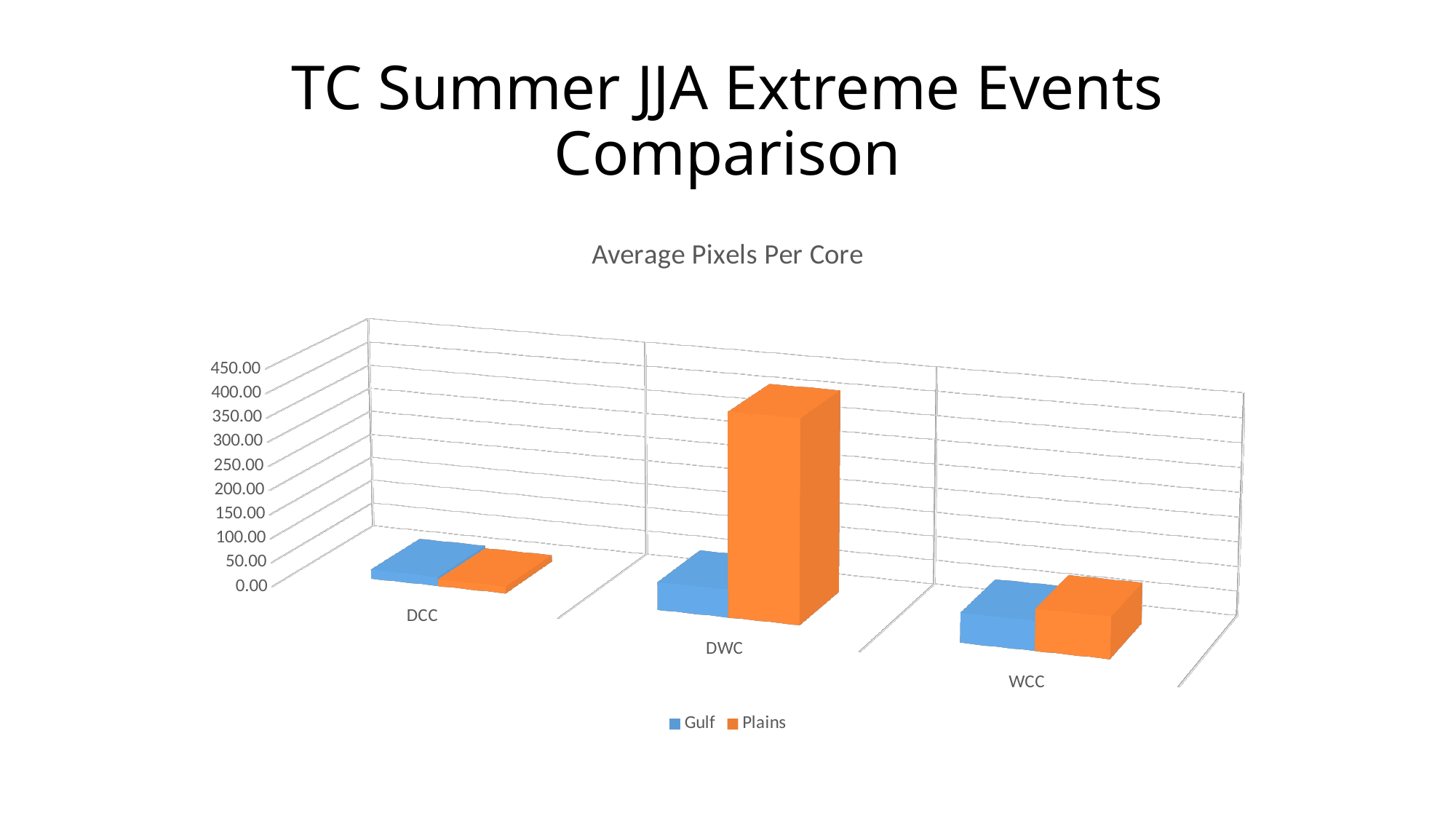
How many series does the legend list? 2 Which is larger, the Plains value for DWC or the Plains value for WCC? Plains value for DWC For DWC, which series has the larger value, Gulf or Plains? Plains What kind of chart is shown on the slide? bar chart Is the Plains value for WCC greater or less than 150? less Is the Gulf value for DWC greater or less than 200? less Is the Plains value for DWC greater or less than 300? greater How many categories are shown on the x axis? 3 What is the title of the chart? Average Pixels Per Core Which category has the highest Plains value? DWC Which series is shown in orange? Plains